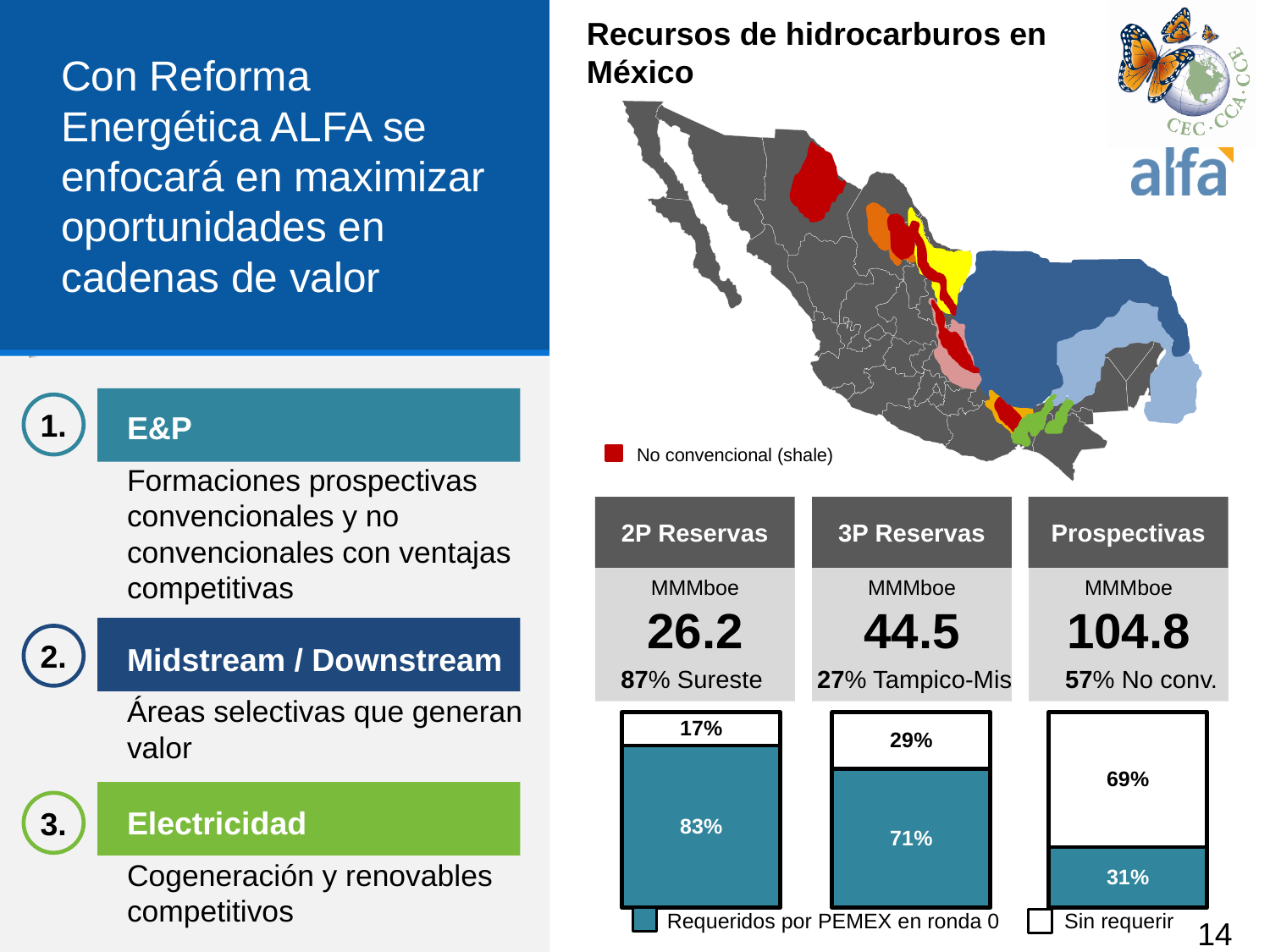
In the stacked bar chart at the bottom right, what percentage of Prospectivas is 'Sin requerir'? 69% In the stacked bar chart at the bottom right, what percentage of 3P Reservas is 'Sin requerir'? 29% How many series does the legend of the stacked bar chart at the bottom right list? 2 In the stacked bar chart at the bottom right, which category has the highest share 'Requeridos por PEMEX en ronda 0'? 2P Reservas In the stacked bar chart at the bottom right, what percentage of Prospectivas is 'Requeridos por PEMEX en ronda 0'? 31% What kind of chart is shown at the bottom right of the slide? Stacked bar chart In the stacked bar chart at the bottom right, what percentage of 2P Reservas is 'Requeridos por PEMEX en ronda 0'? 83% In the stacked bar chart at the bottom right, what is the total of the two segments of the 3P Reservas bar? 100% In the stacked bar chart at the bottom right, what is the difference between the 'Requeridos por PEMEX en ronda 0' shares of 2P Reservas and 3P Reservas? 12% In the stacked bar chart at the bottom right, is the 'Sin requerir' share larger for 3P Reservas or for Prospectivas? Prospectivas How many bars are shown in the stacked bar chart at the bottom right? 3 In the stacked bar chart at the bottom right, which category has the lowest share 'Requeridos por PEMEX en ronda 0'? Prospectivas